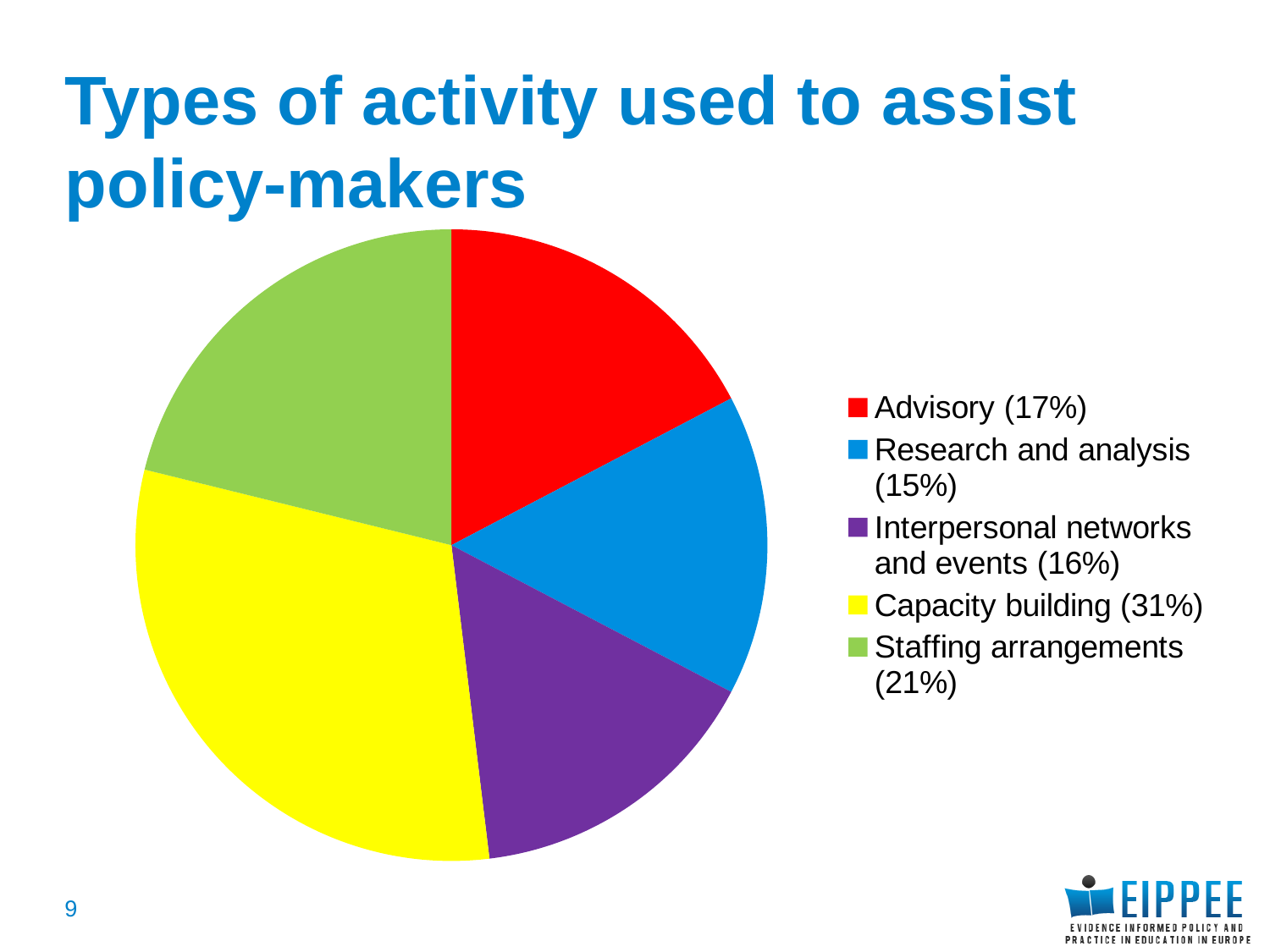
Which type of activity has the largest share of the pie? Capacity building What is the title of the slide containing the pie chart? Types of activity used to assist policy-makers Which has the larger share: Advisory or Research and analysis? Advisory How many percentage points larger is the Capacity building share than the Staffing arrangements share? 10 What percentage is shown for Advisory? 17% What share of the pie does Capacity building account for? 31% What percentage is shown for Staffing arrangements? 21% What kind of chart is shown on the slide? pie chart Which type of activity has the smallest share of the pie? Research and analysis What colour is the Capacity building slice? yellow What percentage is shown for Interpersonal networks and events? 16% How many slices does the pie chart have? 5